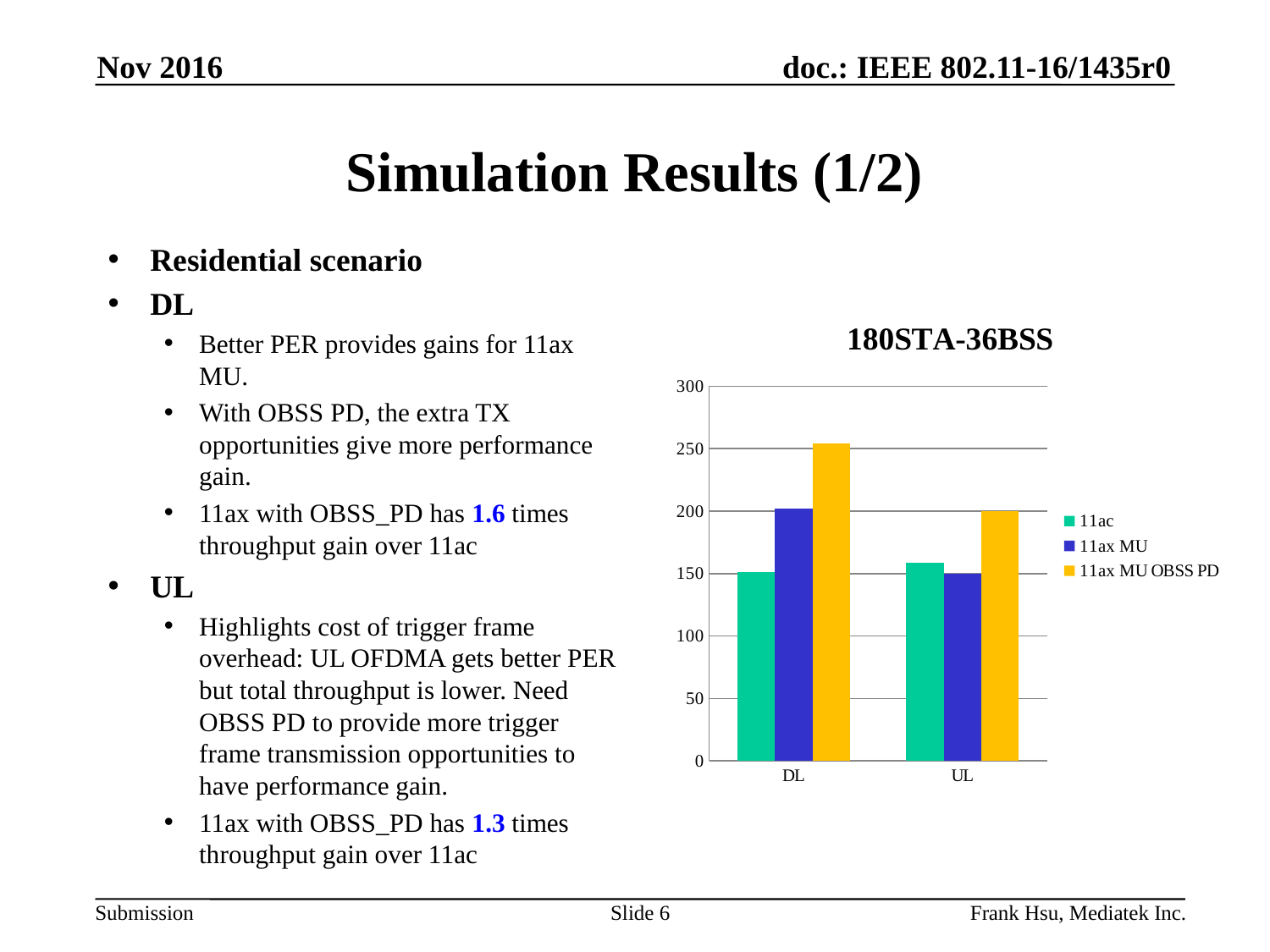
Is the value for 11ax MU in the DL category greater or less than 250? less Which is larger: 11ax MU OBSS PD in UL or 11ac in UL? 11ax MU OBSS PD in UL Is the value for 11ax MU OBSS PD in the UL category greater or less than 150? greater Which series has the lowest bar in the DL category? 11ac What is the title of the chart? 180STA-36BSS Is the value for 11ac in the DL category greater or less than 200? less How many series does the chart legend list? 3 What kind of chart is shown on the slide? bar chart Which series has the highest bar in the DL category? 11ax MU OBSS PD How many categories are shown on the x axis of the chart? 2 Which colour represents the 11ax MU OBSS PD series in the chart? yellow